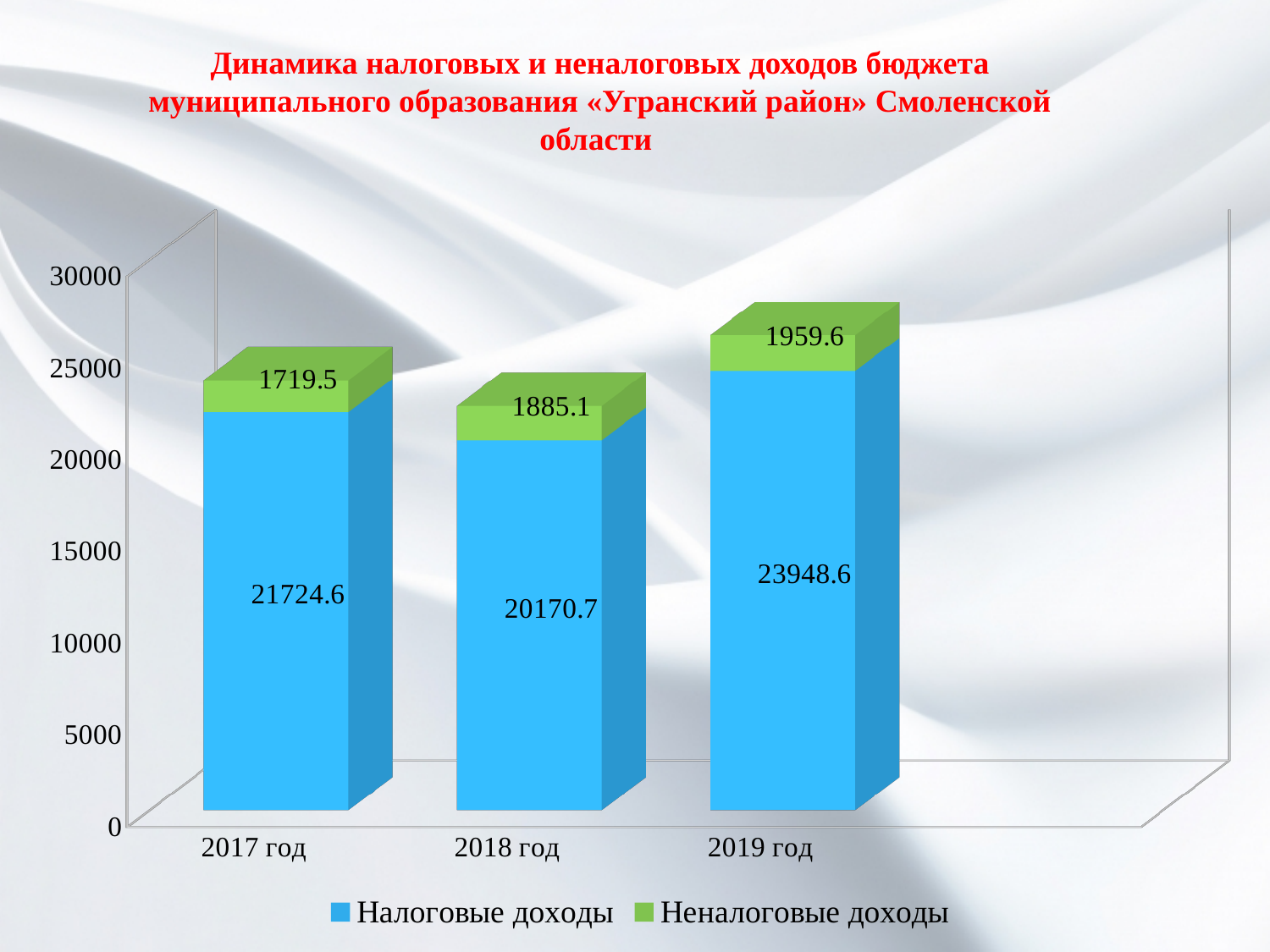
What is the value of Неналоговые доходы for 2018 год? 1885.1 What is the value of Налоговые доходы for 2017 год? 21724.6 In which year is Налоговые доходы the highest? 2019 год Which is larger: Налоговые доходы in 2017 год or in 2018 год? 2017 год How many series does the legend list? 2 In which year is Налоговые доходы the lowest? 2018 год How many years are shown on the x axis? 3 What is the total of the stacked bar for 2019 год? 25908.2 What is the difference between Налоговые доходы in 2019 год and 2017 год? 2224.0 What kind of chart is shown on the slide? Stacked bar chart What is the difference between Неналоговые доходы in 2018 год and 2017 год? 165.6 What is the value of Неналоговые доходы for 2019 год? 1959.6